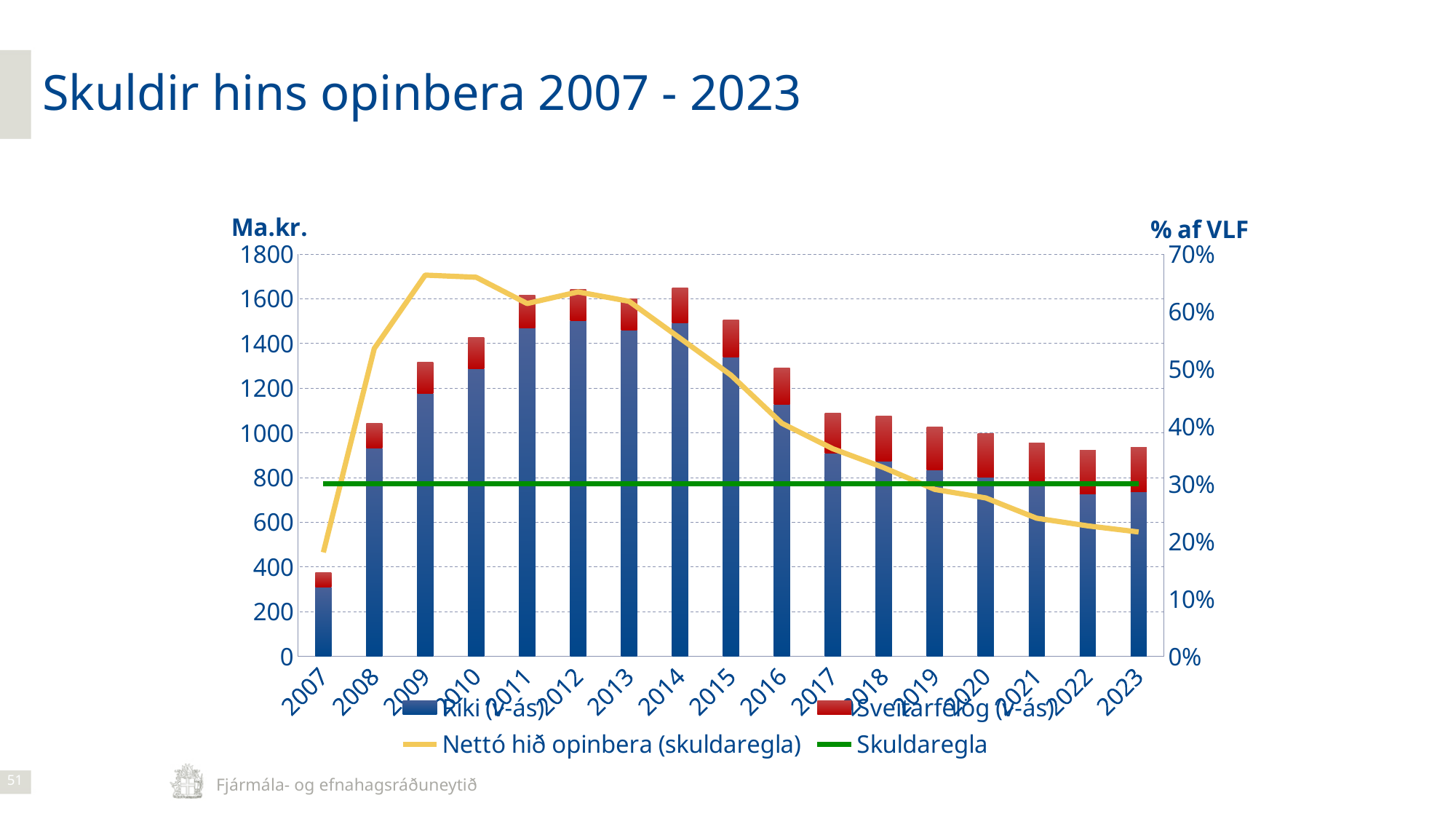
How many years are shown along the x axis? 17 Is the total stacked bar for 2007 greater or less than 600 Ma.kr.? less Which year has the larger total stacked bar, 2015 or 2016? 2015 Is the value of the Nettó hið opinbera (skuldaregla) line in 2023 greater or less than 30%? less Is the total stacked bar for 2009 greater or less than 1200 Ma.kr.? greater How many series does the legend list? 4 What is the label of the right-hand vertical axis? % af VLF Which year has the lowest total stacked bar? 2007 What kind of chart is shown on the slide? A combined bar and line chart Does the Nettó hið opinbera (skuldaregla) line rise or fall from 2014 to 2023? fall